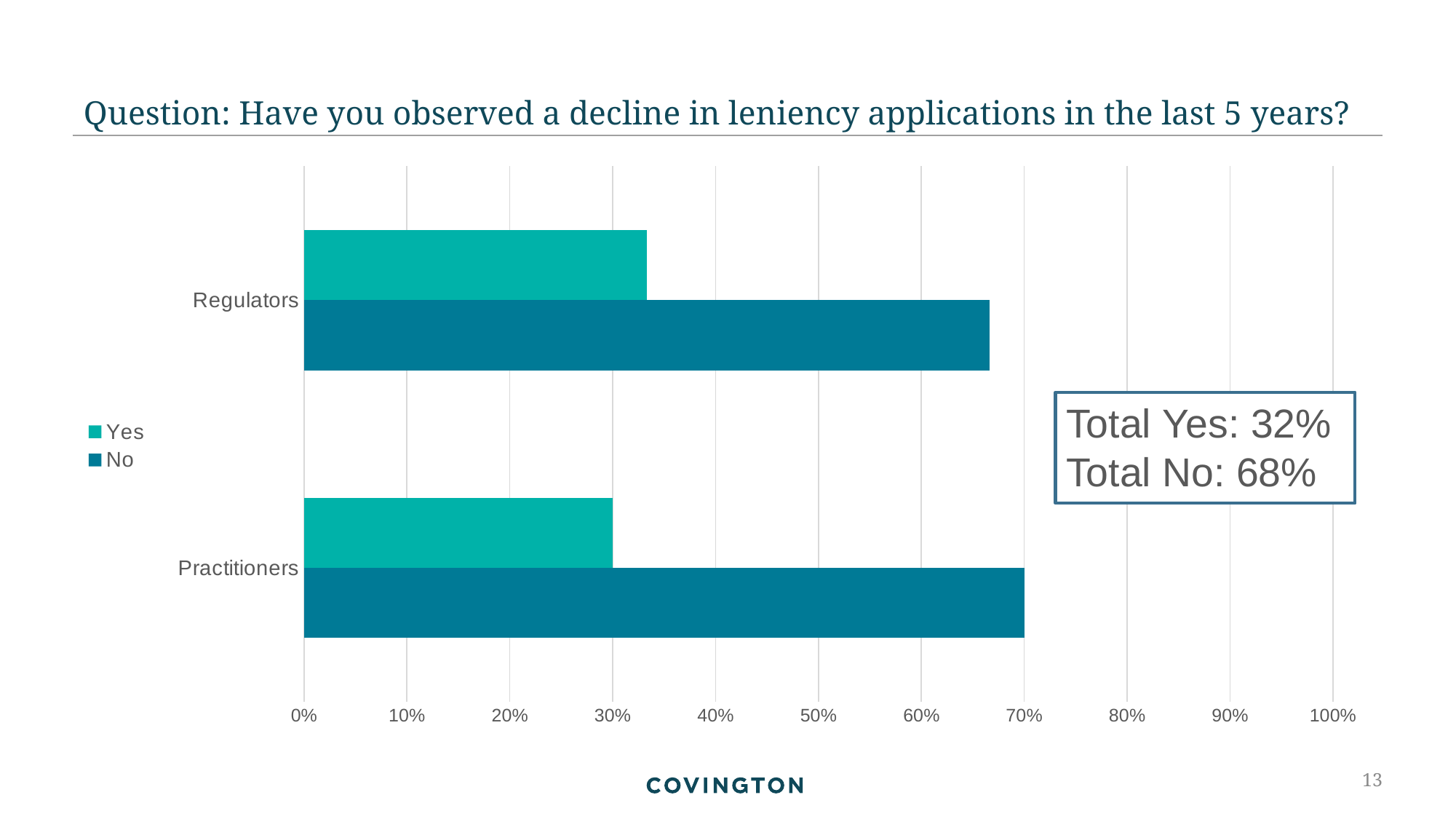
Which category has the higher No value, Regulators or Practitioners? Practitioners What Total Yes percentage is stated in the text box on the slide? 32% What kind of chart is shown on the slide? bar chart Is the No value for Regulators greater or less than 70%? less What is the Yes value for Practitioners? 30% Which is larger for Regulators, the Yes value or the No value? No Which series is shown in the lighter teal colour? Yes How many respondent categories are shown on the chart? 2 What is the difference between the No and Yes values for Practitioners? 40% Is the Yes value for Regulators greater or less than 30%? greater What is the No value for Practitioners? 70% How many series does the legend list? 2